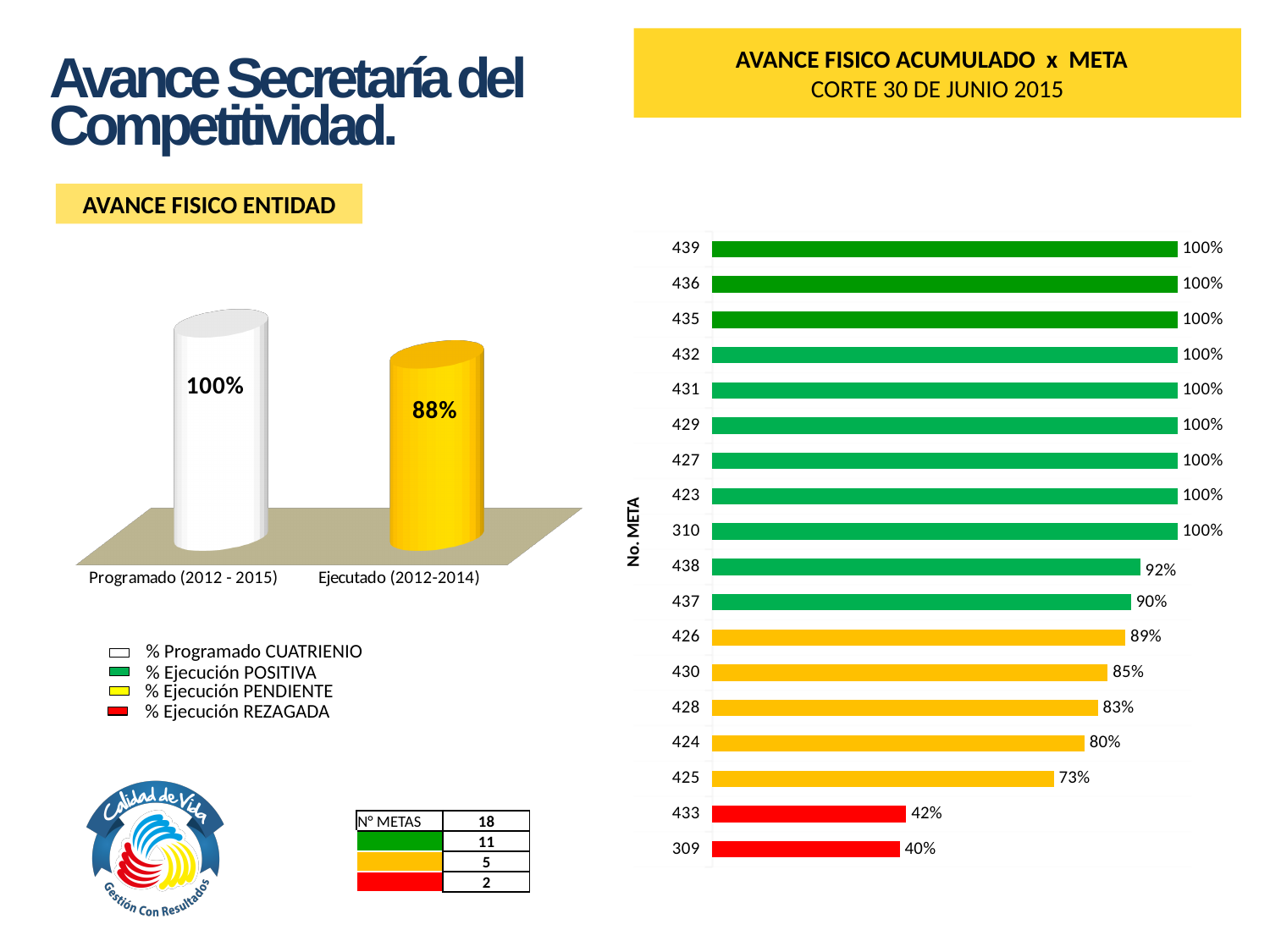
In the AVANCE FISICO ENTIDAD chart, what is the value for Ejecutado (2012-2014)? 88% In the AVANCE FISICO ACUMULADO x META chart, what colour are the bars for metas 433 and 309? Red In the AVANCE FISICO ACUMULADO x META chart, what is the value for meta 438? 92% In the AVANCE FISICO ENTIDAD chart, how many bars are plotted? 2 What kind of chart is the AVANCE FISICO ACUMULADO x META chart? Bar chart In the AVANCE FISICO ACUMULADO x META chart, how many metas are plotted? 18 In the AVANCE FISICO ACUMULADO x META chart, which is larger, the value for meta 430 or meta 424? 430 In the AVANCE FISICO ACUMULADO x META chart, what is the difference between meta 426 and meta 433? 47% In the AVANCE FISICO ACUMULADO x META chart, which meta has the lowest value? 309 In the AVANCE FISICO ENTIDAD chart, what is the value for Programado (2012 - 2015)? 100% In the AVANCE FISICO ENTIDAD chart, what is the difference between Programado (2012 - 2015) and Ejecutado (2012-2014)? 12% In the AVANCE FISICO ACUMULADO x META chart, what is the value for meta 425? 73%